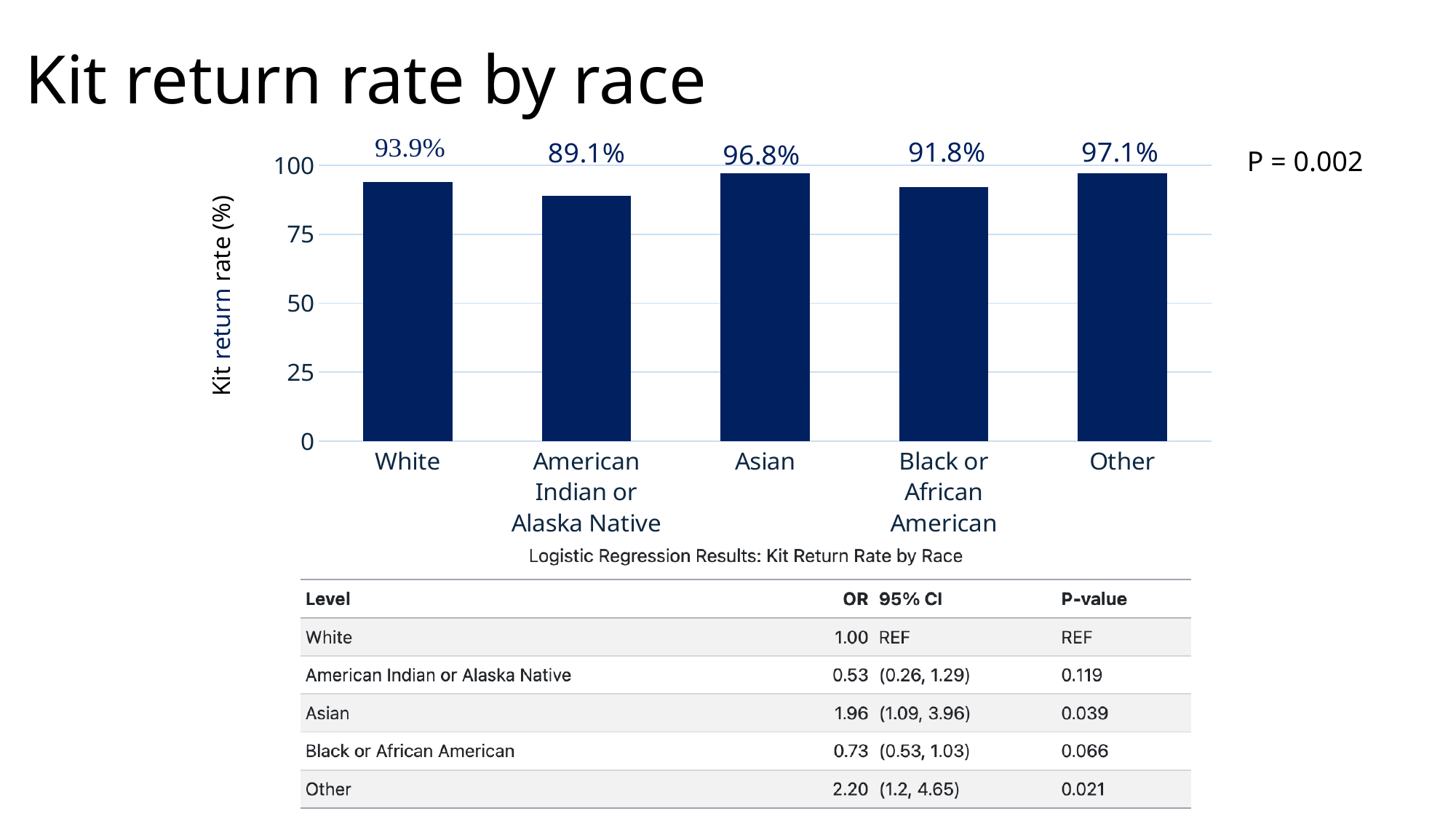
Which race category has the highest kit return rate? Other What is the kit return rate for White? 93.9% Which has a higher kit return rate, White or Black or African American? White What is the difference in kit return rate between Asian and American Indian or Alaska Native? 7.7% What is the kit return rate for Asian? 96.8% What is the kit return rate for American Indian or Alaska Native? 89.1% What is the kit return rate for Black or African American? 91.8% How many race categories are shown in the chart? 5 What kind of chart is shown on the slide? Bar chart What is the label of the y axis? Kit return rate (%) Which race category has the lowest kit return rate? American Indian or Alaska Native What P value is shown next to the chart? P = 0.002